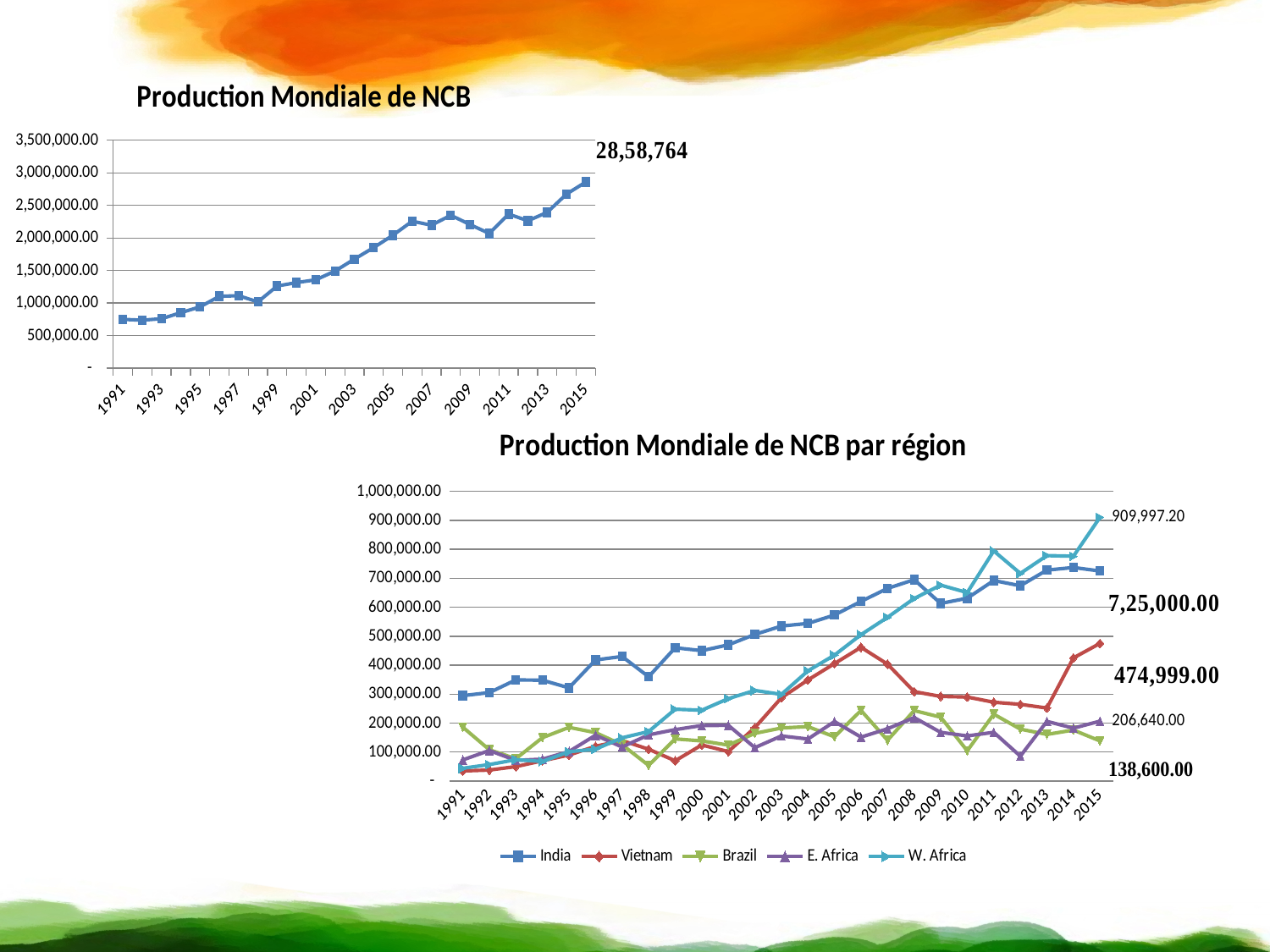
In the bottom chart 'Production Mondiale de NCB par région', which region has the lowest value in 2015? Brazil In the bottom chart 'Production Mondiale de NCB par région', which region has the highest value in 2015? W. Africa In the bottom chart 'Production Mondiale de NCB par région', what is the labelled value for Vietnam in 2015? 474,999.00 In the top chart 'Production Mondiale de NCB', do the values generally rise or fall from 1991 to 2015? rise In the bottom chart 'Production Mondiale de NCB par région', what is the difference between the 2015 values of Vietnam and Brazil? 336,399.00 In the top chart 'Production Mondiale de NCB', what value is labelled for 2015? 28,58,764 How many series does the legend of the bottom chart 'Production Mondiale de NCB par région' list? 5 In the bottom chart 'Production Mondiale de NCB par région', what is the labelled value for W. Africa in 2015? 909,997.20 In the bottom chart 'Production Mondiale de NCB par région', what is the labelled value for Brazil in 2015? 138,600.00 In the top chart 'Production Mondiale de NCB', is the value for 1991 greater or less than 1,000,000.00? less In the bottom chart 'Production Mondiale de NCB par région', what is the labelled value for India in 2015? 7,25,000.00 What kind of chart is the top chart titled 'Production Mondiale de NCB'? line chart